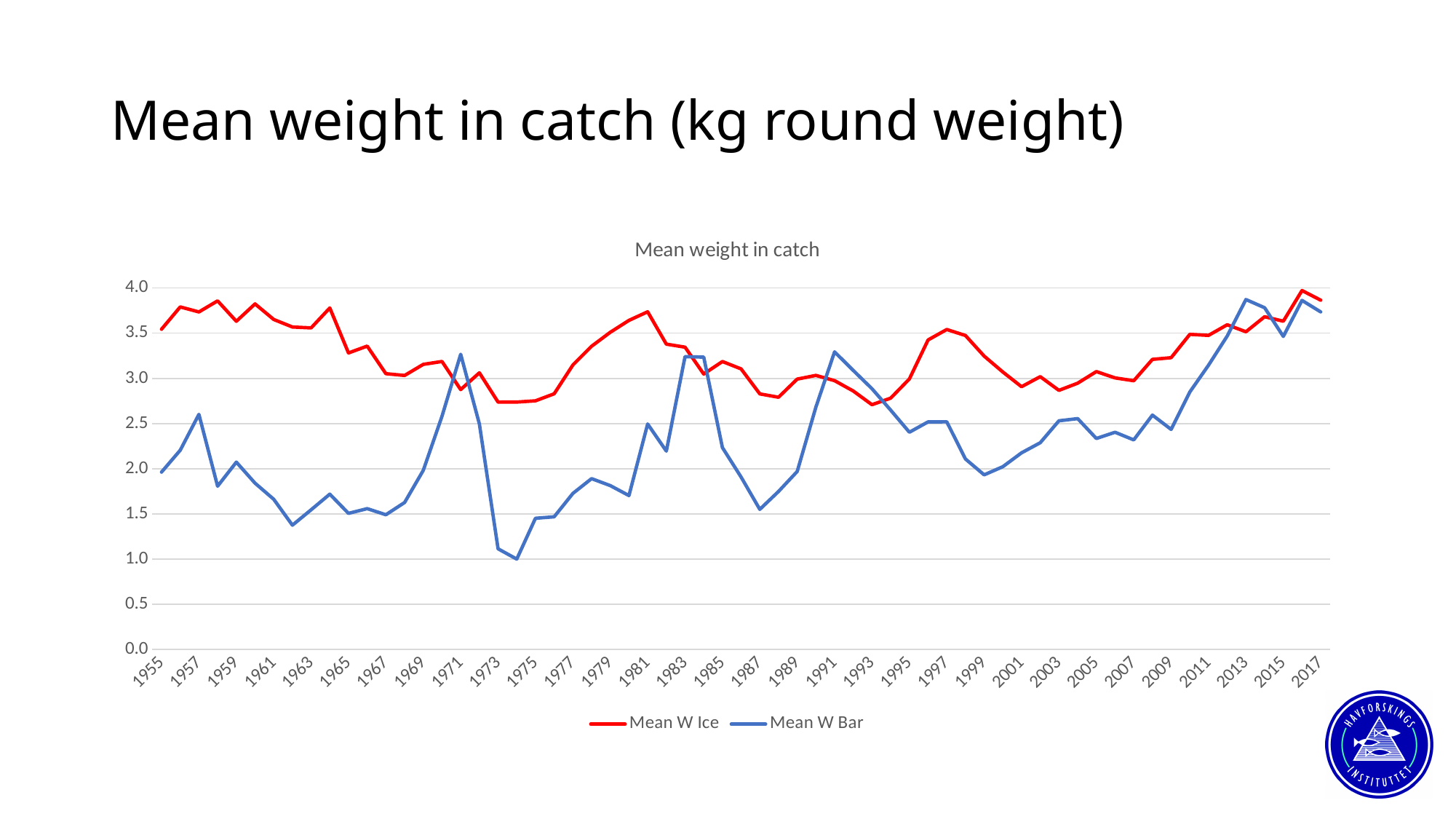
Is the value for Mean W Bar in 2013 greater or less than 3.5? greater How many series does the legend list? 2 In 1971, which series has the larger value, Mean W Ice or Mean W Bar? Mean W Bar What kind of chart is shown on the slide? Line chart Does the Mean W Bar series rise or fall between 2007 and 2013? Rise Is the value for Mean W Bar in 1974 greater or less than 1.5? less Is the value for Mean W Ice in 1959 greater or less than 3.5? greater In which year does the Mean W Bar series reach its lowest value? 1974 In 1959, which series has the larger value, Mean W Ice or Mean W Bar? Mean W Ice What colour is the Mean W Ice line? Red What is the title printed above the chart area? Mean weight in catch